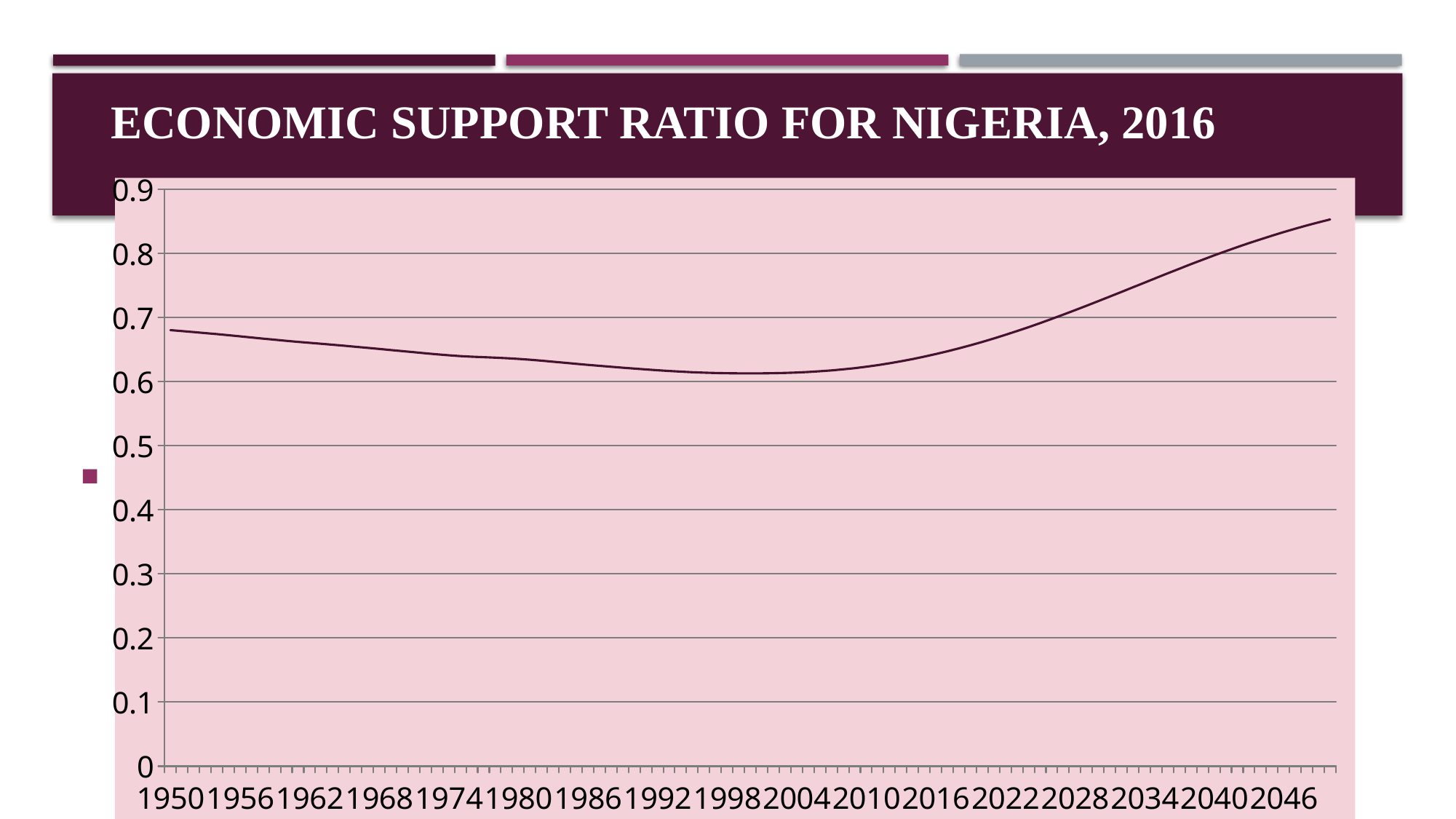
Is the value for 1950 greater or less than 0.6? greater Which is larger, the value for 1950 or the value for 2046? 2046 Which is larger, the value for 1950 or the value for 1998? 1950 Is the value for 2046 greater or less than 0.8? greater Is the value for 1950 greater or less than 0.7? less What is the highest value shown on the vertical axis? 0.9 What is the title of the chart? ECONOMIC SUPPORT RATIO FOR NIGERIA, 2016 Do the values rise or fall between 1950 and 1998? fall What kind of chart is shown on the slide? line chart Do the values rise or fall between 2010 and 2046? rise